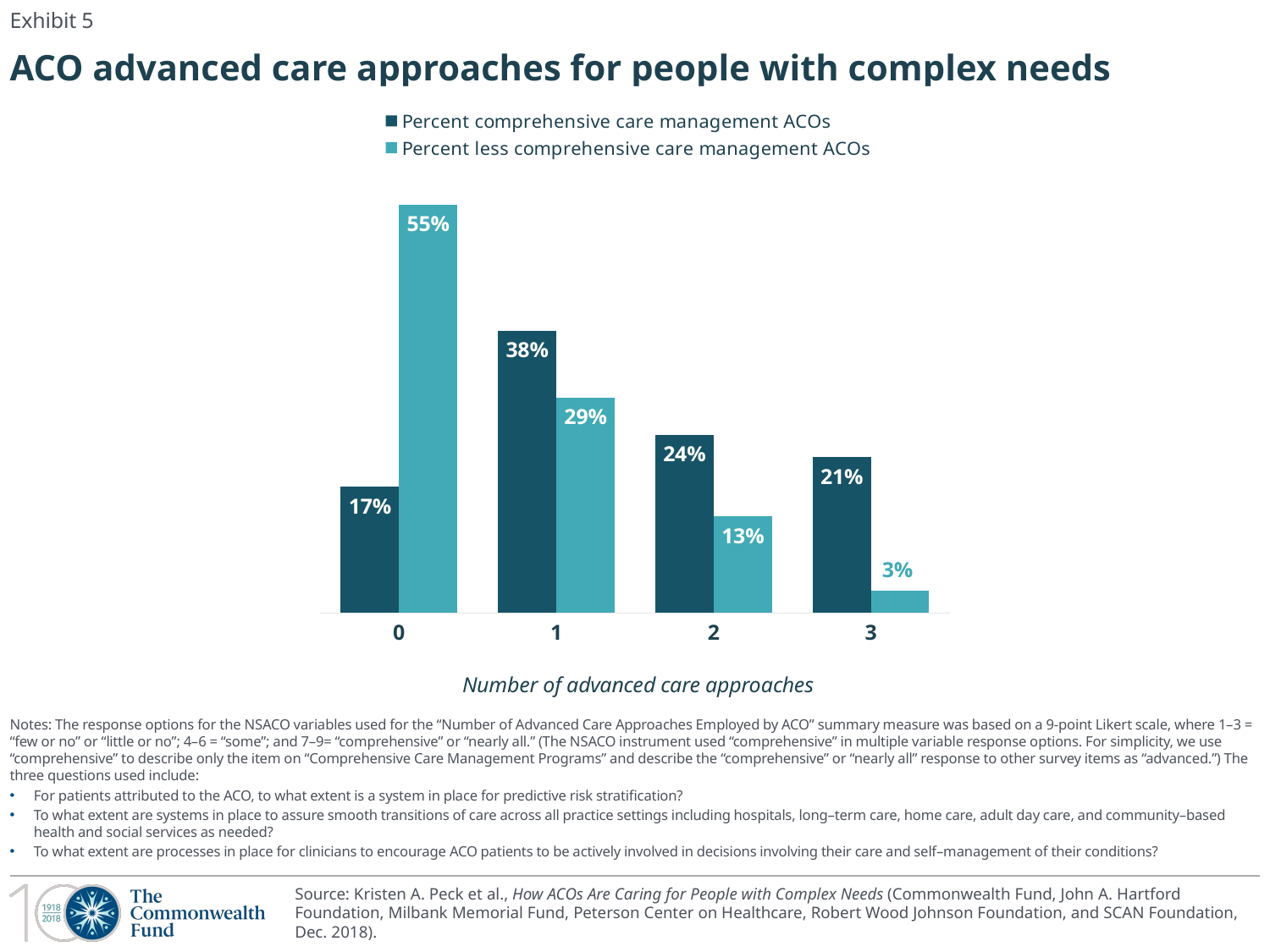
For which number of advanced care approaches is the percent of less comprehensive care management ACOs lowest? 3 For which number of advanced care approaches is the percent of comprehensive care management ACOs highest? 1 What percent of less comprehensive care management ACOs have 3 advanced care approaches? 3% What percent of comprehensive care management ACOs have 1 advanced care approach? 38% What percent of less comprehensive care management ACOs have 0 advanced care approaches? 55% How many series does the legend list? 2 What is the x-axis label of the chart? Number of advanced care approaches Which is larger for ACOs with 0 advanced care approaches: the percent of comprehensive or less comprehensive care management ACOs? Percent less comprehensive care management ACOs What kind of chart is shown on the slide? Bar chart Does the percent of less comprehensive care management ACOs rise or fall as the number of advanced care approaches increases? Fall What is the difference between the percent of comprehensive and less comprehensive care management ACOs with 2 advanced care approaches? 11% How many categories are shown on the x axis? 4